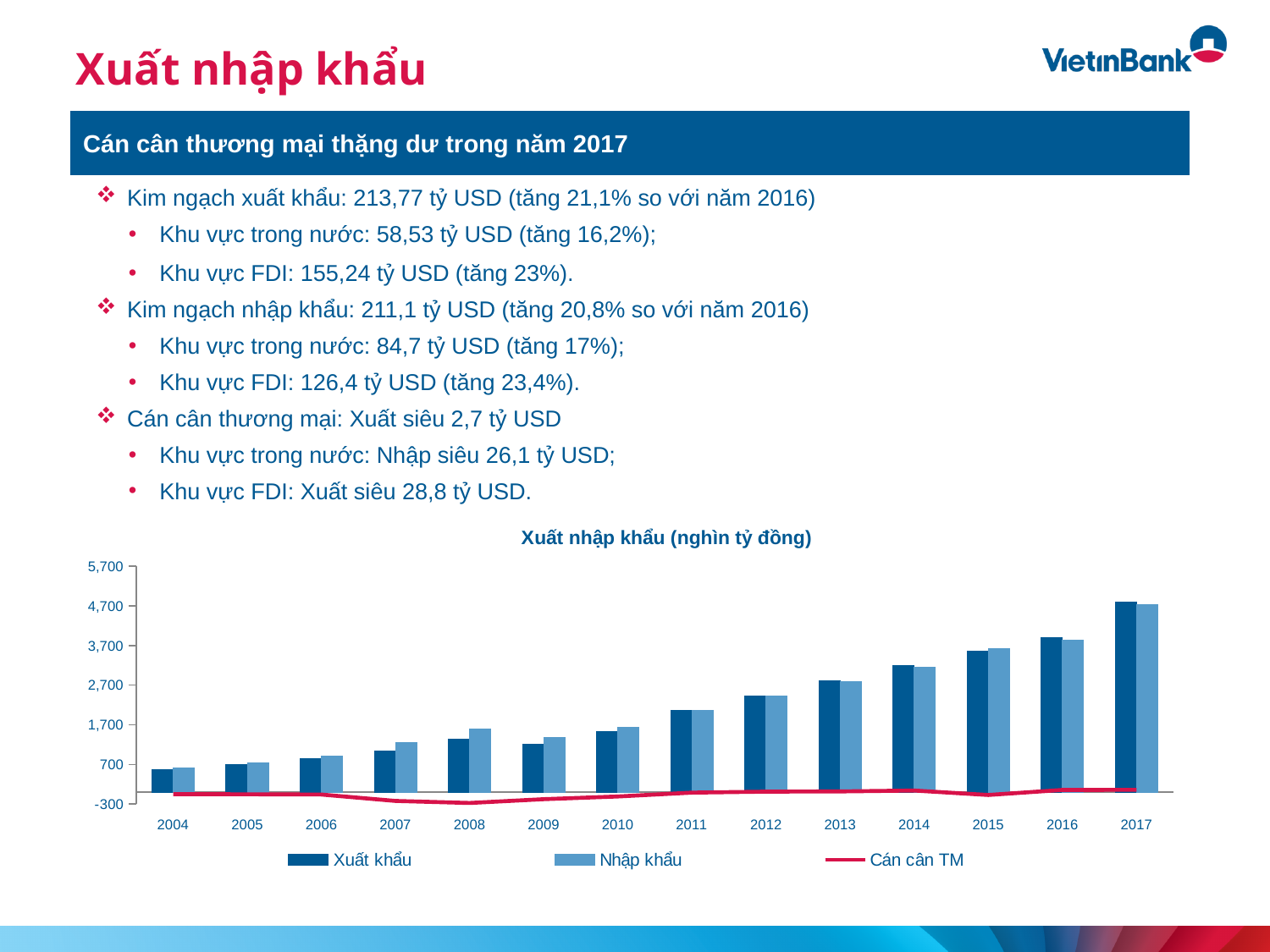
Which year has the highest Xuất khẩu bar? 2017 Which year has the lowest Xuất khẩu bar? 2004 How many years are shown on the x axis of the chart? 14 Is the Xuất khẩu value for 2004 greater or less than 700? less Is the Xuất khẩu value for 2017 greater or less than 3,700? greater Is the Xuất khẩu value for 2015 greater or less than 2,700? greater How many series does the chart legend list? 3 Do the Xuất khẩu values generally rise or fall from 2004 to 2017? rise What kind of chart is shown on the slide? Bar chart with a line In 2008, which is larger, Xuất khẩu or Nhập khẩu? Nhập khẩu What is the title of the chart? Xuất nhập khẩu (nghìn tỷ đồng)